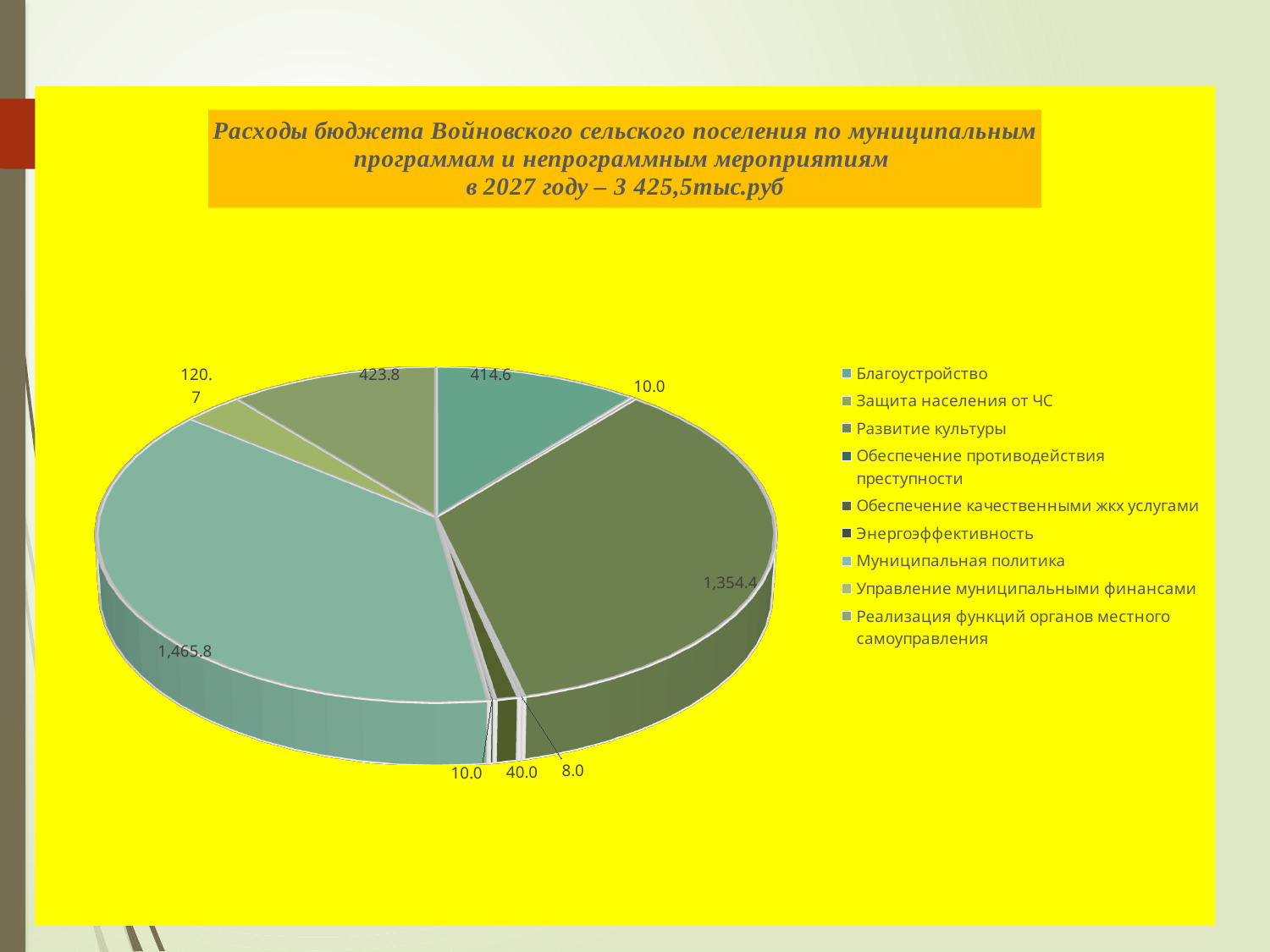
Which category has the largest slice of the pie? Муниципальная политика Which year does the chart title say the budget expenditures refer to? 2027 What is the value for Благоустройство? 414.6 Which category has the smallest value in the pie chart? Обеспечение противодействия преступности How many categories does the legend of the pie chart list? 9 What is the value for Реализация функций органов местного самоуправления? 423.8 Which is larger, the value for Управление муниципальными финансами or the value for Обеспечение качественными жкх услугами? Управление муниципальными финансами What is the value for Обеспечение качественными жкх услугами? 40.0 What is the difference between the values for Муниципальная политика and Развитие культуры? 111.4 What is the value for Развитие культуры? 1,354.4 What kind of chart is shown on the slide? pie chart What is the value for Муниципальная политика? 1,465.8